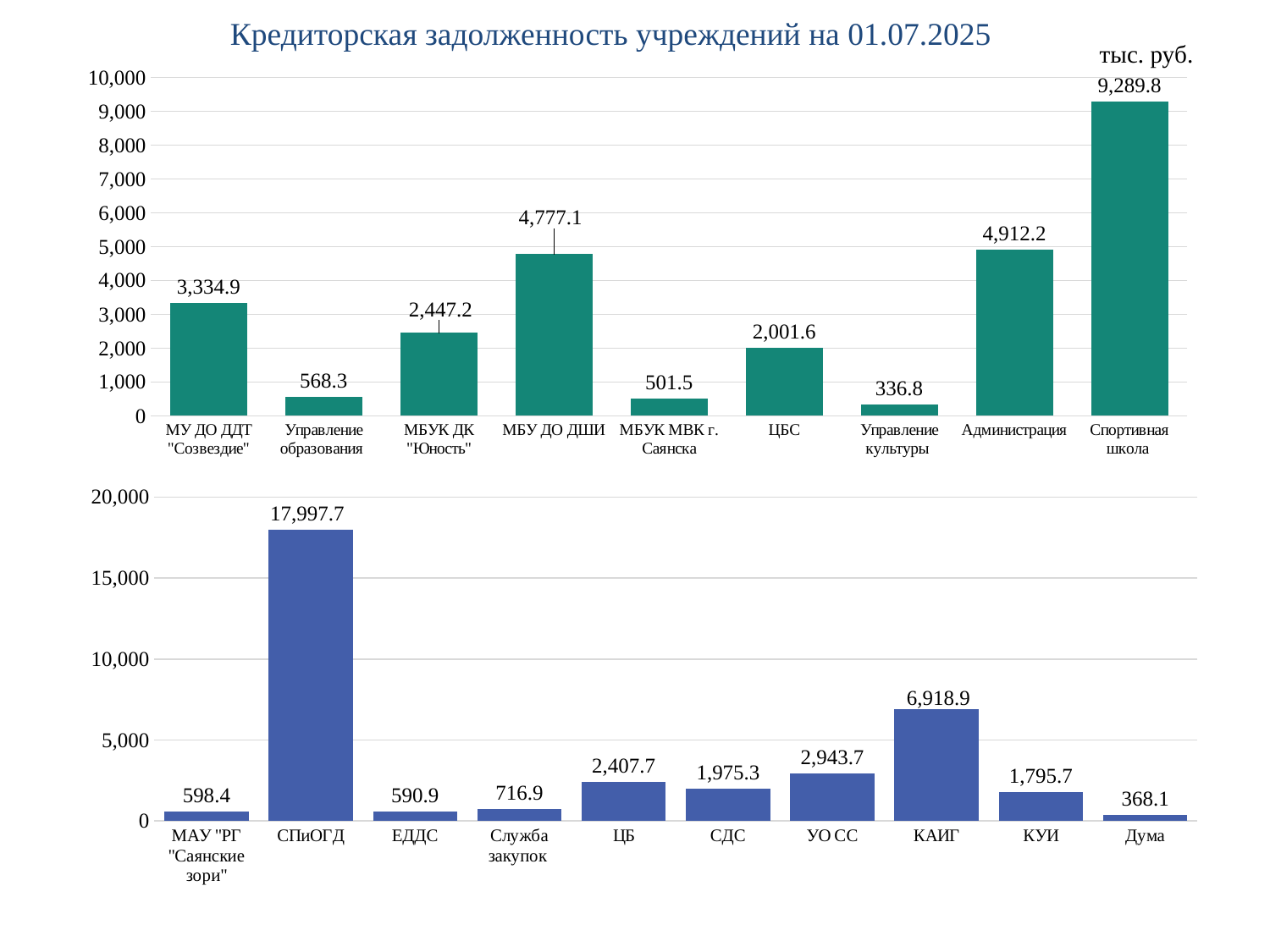
In the top chart, what is the value for Спортивная школа? 9,289.8 In the bottom chart, which category has the lowest value? Дума In the top chart, what is the difference between Администрация and МБУ ДО ДШИ? 135.1 In the bottom chart, how many categories are shown? 10 In the bottom chart, what is the difference between КАИГ and УО СС? 3,975.2 What type of chart is the bottom chart? bar chart In the top chart, what is the value for МБУК ДК "Юность"? 2,447.2 In the bottom chart, which category has the highest value? СПиОГД In the top chart, which category has the lowest value? Управление культуры In the top chart, how many categories are shown? 9 In the top chart, which is larger: ЦБС or МБУК МВК г. Саянска? ЦБС In the bottom chart, what is the value for СПиОГД? 17,997.7